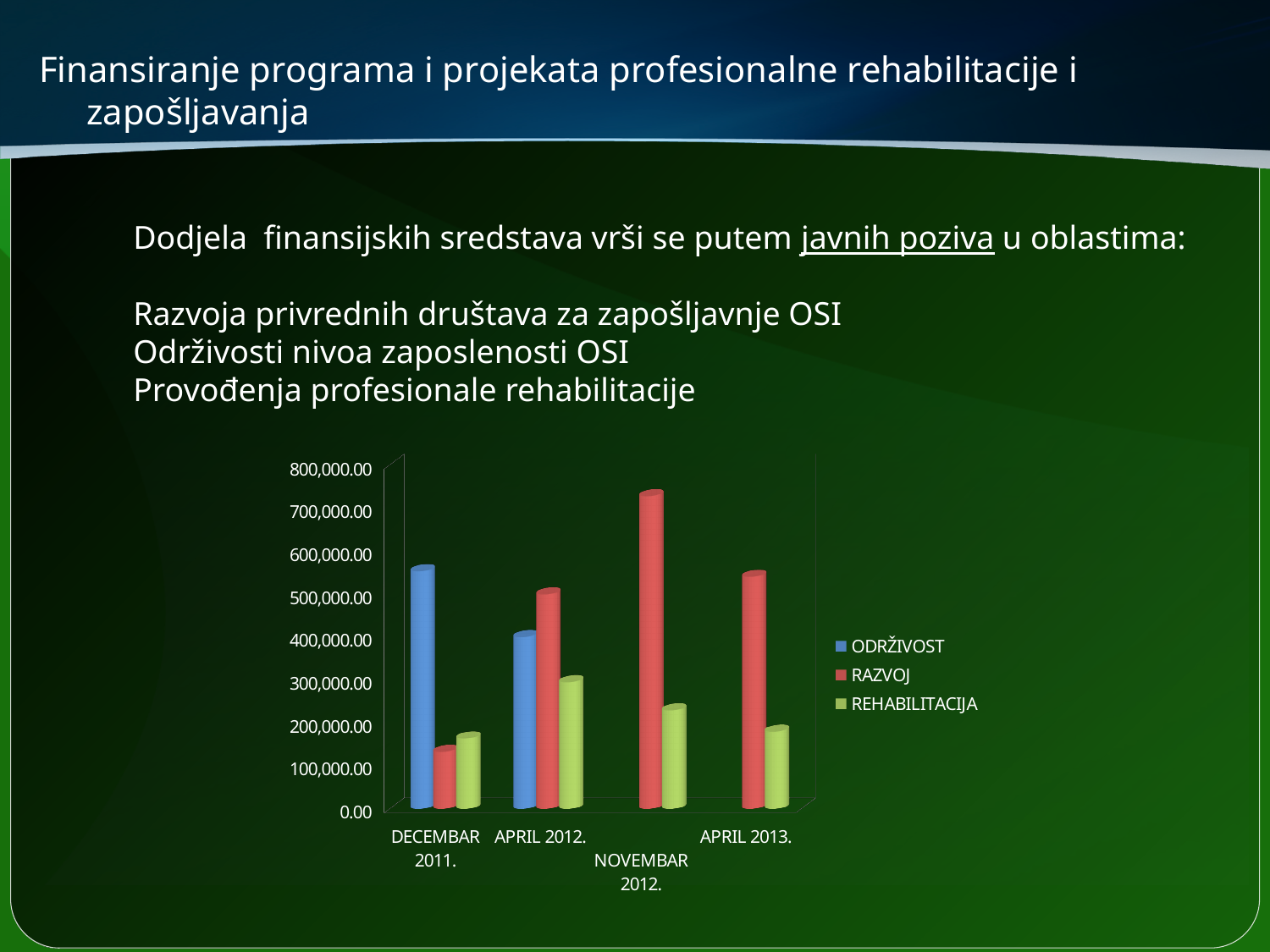
Which series is represented by the red bars in the chart? RAZVOJ In which category does the RAZVOJ series reach its highest value? NOVEMBAR 2012. In which category is the RAZVOJ value the lowest? DECEMBAR 2011. Is the RAZVOJ value for NOVEMBAR 2012. greater or less than 600,000.00? greater Is the ODRŽIVOST value for DECEMBAR 2011. greater or less than 500,000.00? greater Is the REHABILITACIJA value for APRIL 2013. greater or less than 300,000.00? less For APRIL 2012., which series has the larger value, ODRŽIVOST or RAZVOJ? RAZVOJ How many series does the chart legend list? 3 In which category does the REHABILITACIJA series reach its highest value? APRIL 2012. How many categories are shown on the x axis of the chart? 4 What kind of chart is shown on the slide? bar chart For DECEMBAR 2011., which series has the larger value, ODRŽIVOST or REHABILITACIJA? ODRŽIVOST